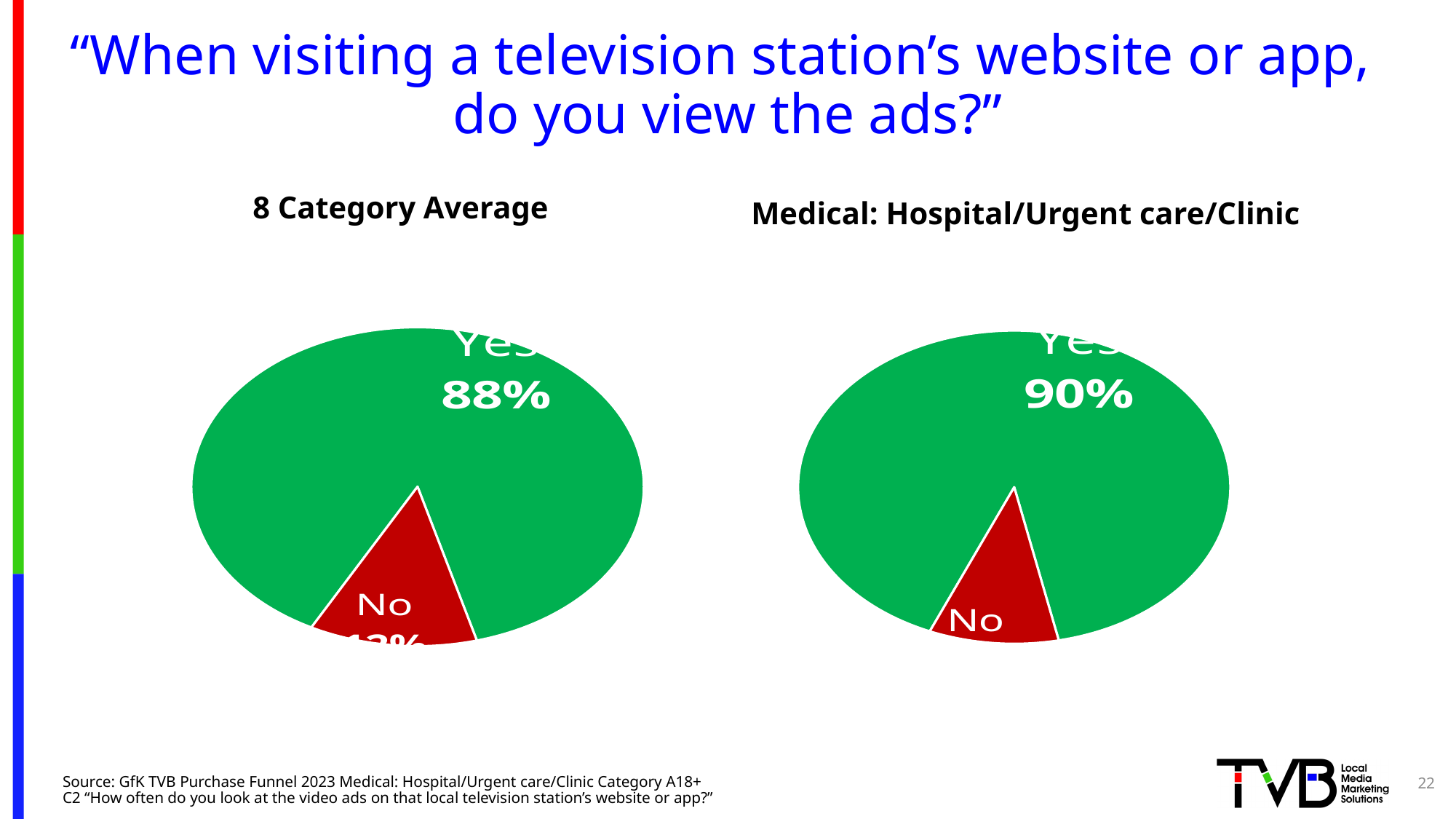
How many pie charts are shown on the slide? 2 Which chart shows the higher Yes percentage, 8 Category Average or Medical: Hospital/Urgent care/Clinic? Medical: Hospital/Urgent care/Clinic In the 8 Category Average chart, what percentage answered Yes? 88% What is the title of the pie chart on the left side of the slide? 8 Category Average What colour is the Yes slice in the Medical: Hospital/Urgent care/Clinic chart? Green In the 8 Category Average chart, which slice is the smallest? No How many slices does the 8 Category Average pie chart have? 2 How many percentage points higher is the Yes share in the Medical: Hospital/Urgent care/Clinic chart than in the 8 Category Average chart? 2 percentage points In the Medical: Hospital/Urgent care/Clinic chart, which slice is the largest? Yes What kind of chart is the 8 Category Average chart? Pie chart In the Medical: Hospital/Urgent care/Clinic chart, what percentage answered Yes? 90% In the Medical: Hospital/Urgent care/Clinic chart, which is larger, the Yes slice or the No slice? Yes